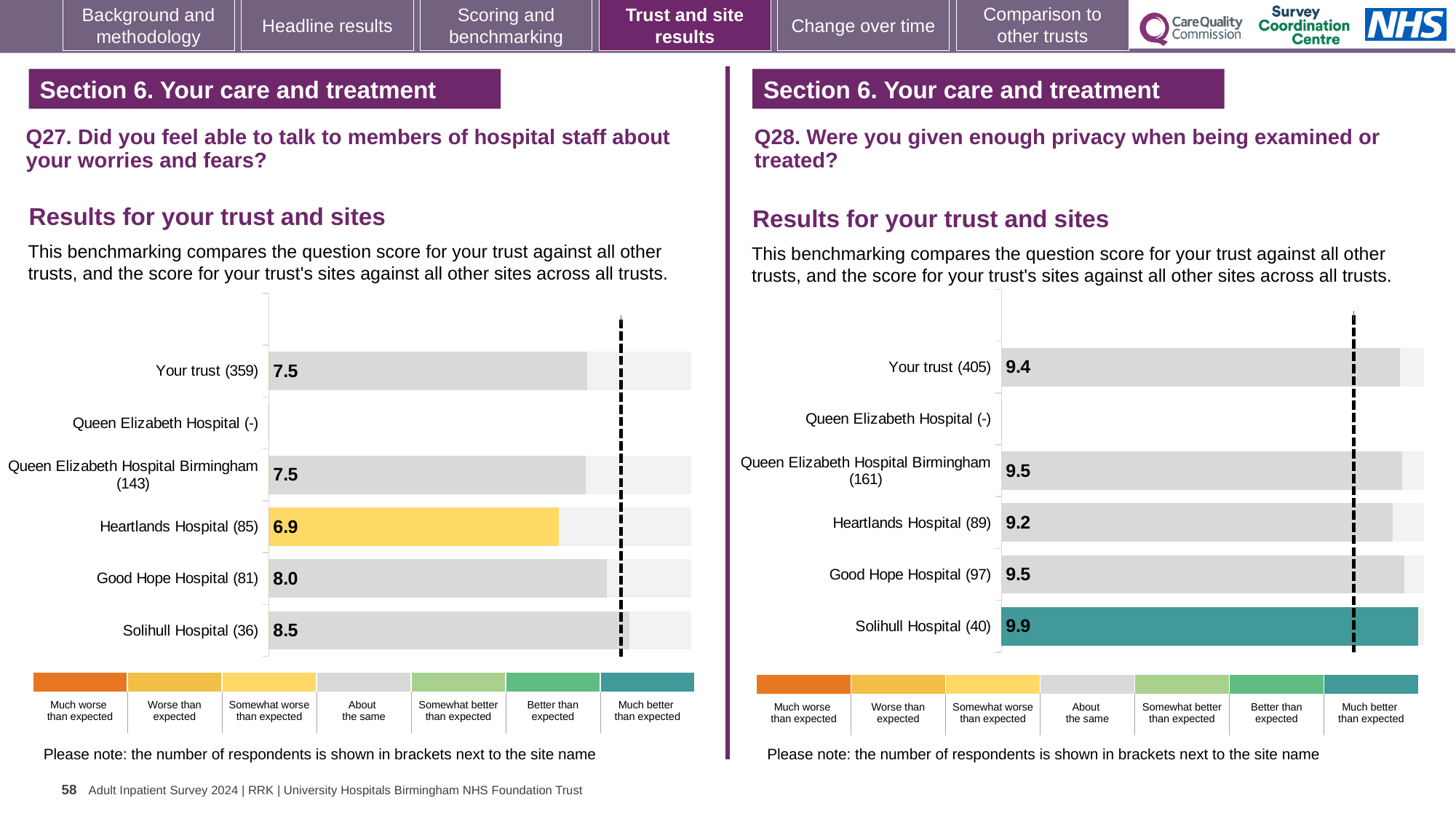
What kind of chart is used for the Q28 results on the right? bar chart In the Q27 chart on the left, what is the score for Heartlands Hospital? 6.9 In the Q27 chart on the left, which site has the highest score? Solihull Hospital In the Q28 chart on the right, what is the score for Solihull Hospital? 9.9 In the Q27 chart on the left, what is the difference between the scores for Solihull Hospital and Heartlands Hospital? 1.6 In the Q28 chart on the right, is the score for Good Hope Hospital larger or smaller than the score for Heartlands Hospital? larger In the Q28 chart on the right, which site has the lowest score? Heartlands Hospital In the Q28 chart on the right, what is the score for Your trust? 9.4 In the Q27 chart on the left, which bar is coloured yellow rather than grey? Heartlands Hospital In the Q27 chart on the left, what is the score for Your trust? 7.5 In the Q28 chart on the right, what is the difference between the scores for Solihull Hospital and Your trust? 0.5 In the Q27 chart on the left, which site has the lowest score? Heartlands Hospital